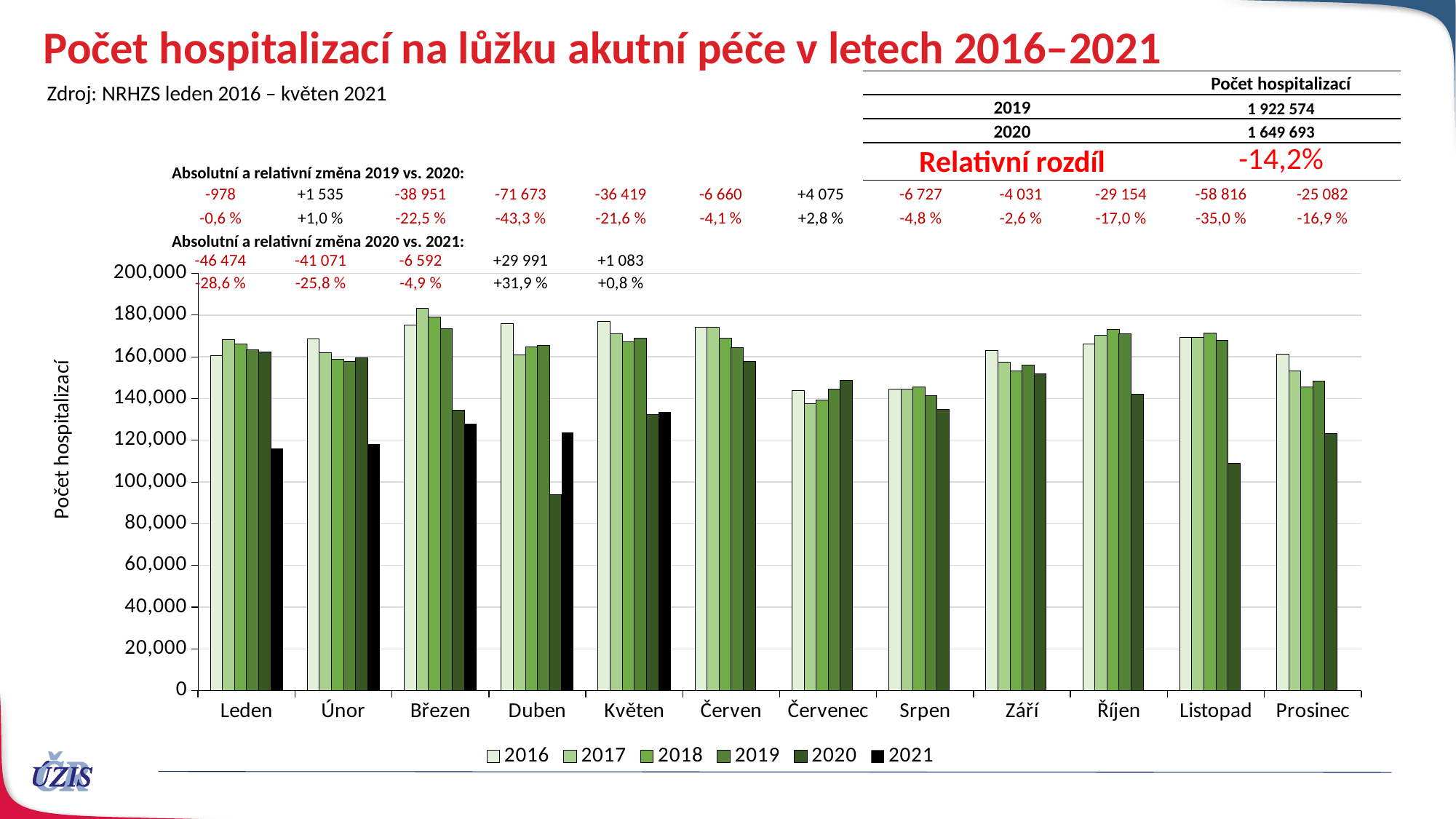
What kind of chart is shown on the slide? bar chart Which year has the lowest bar in Duben? 2020 In Leden, which is larger: the bar for 2016 or the bar for 2021? 2016 According to the table on the slide, what is the relative difference (Relativní rozdíl) between 2019 and 2020? -14,2% Which year has the highest bar in Březen? 2017 Do the 2020 bars rise or fall from Září to Listopad? fall Is the value for 2017 in Březen greater or less than 180,000? greater Is the value for 2021 in Leden greater or less than 120,000? less According to the annotation above the chart, what is the absolute change 2019 vs. 2020 for Duben? -71 673 How many months are shown along the x axis of the chart? 12 Is the value for 2020 in Duben greater or less than 100,000? less How many series does the chart legend list? 6